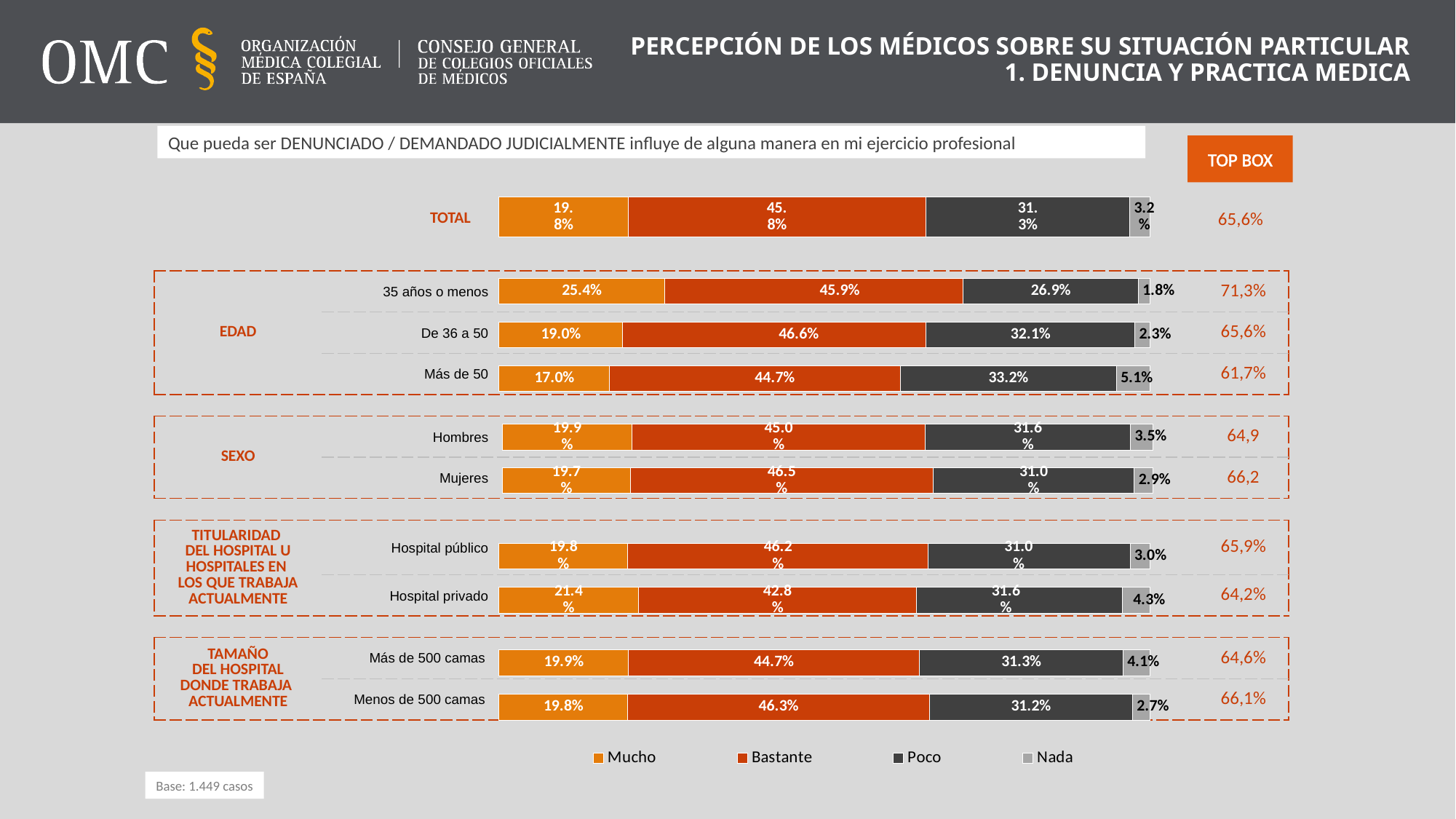
What are the legend entries of the chart? Mucho, Bastante, Poco, Nada What kind of chart is shown on the slide? Stacked horizontal bar chart Which category has the lowest Mucho value? Más de 50 What is the value of the Bastante segment for the 'De 36 a 50' bar? 46.6% What is the difference between the Poco values for 'Más de 50' and '35 años o menos'? 6.3 percentage points Which category has the highest Mucho value? 35 años o menos Which has the larger Bastante value, 'Hospital público' or 'Hospital privado'? Hospital público What is the value of the Nada segment for the 'Más de 50' bar? 5.1% What is the value of the Poco segment for the 'Menos de 500 camas' bar? 31.2% How many bars are shown in the chart? 10 What is the value of the Mucho segment for the '35 años o menos' bar? 25.4% How many series does the legend list? 4